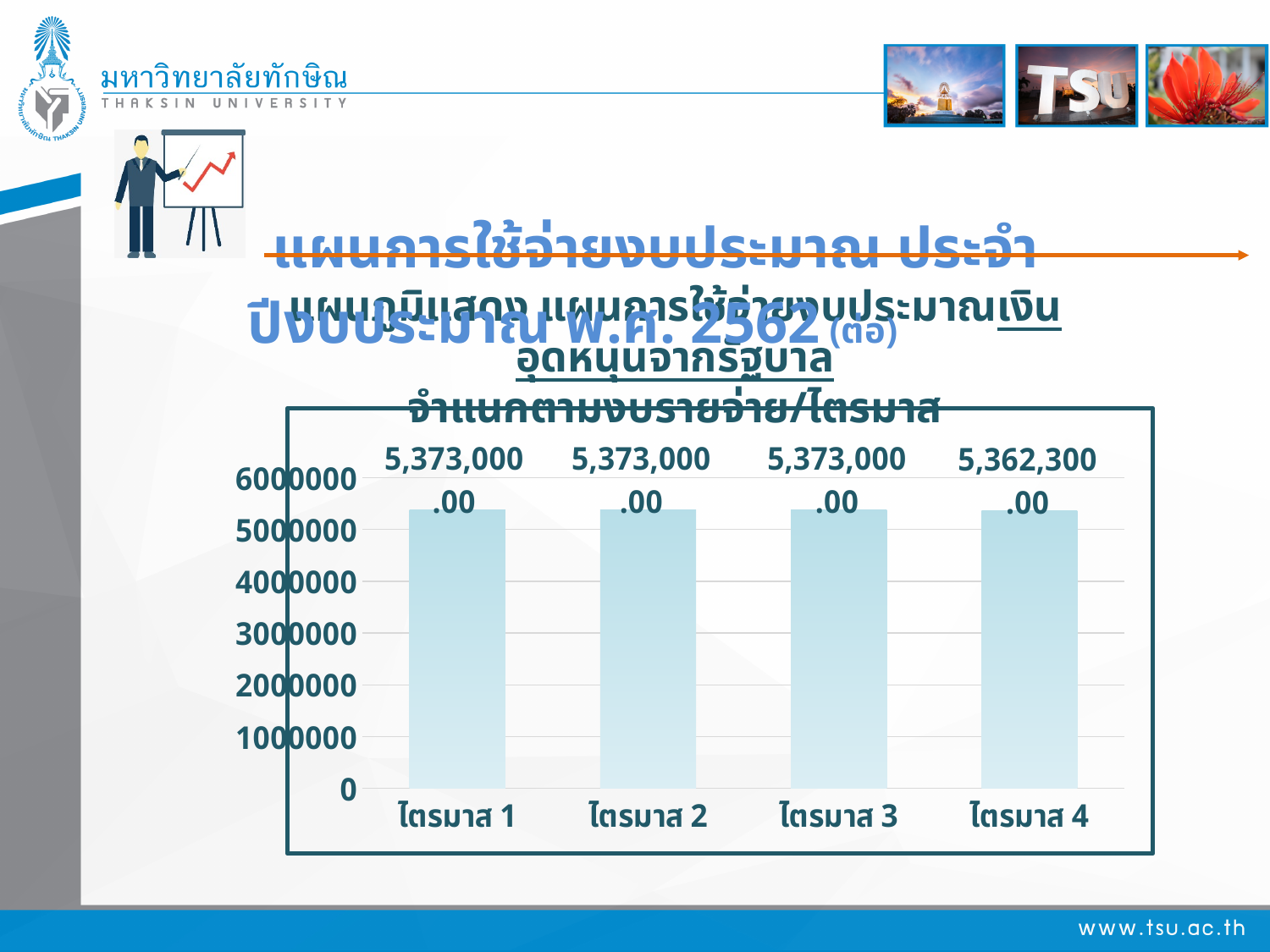
Is the value for ไตรมาส 2 greater or less than 5000000? greater What is the highest tick value shown on the vertical axis? 6000000 Do the values for ไตรมาส 1, 2 and 3 differ from each other? No, they are all 5,373,000.00 What is the value for ไตรมาส 1? 5,373,000.00 How many quarters (categories) are shown on the chart? 4 What kind of chart is shown on the slide? bar chart What is the value for ไตรมาส 2? 5,373,000.00 Which quarter has the lowest value? ไตรมาส 4 Which is larger, the value for ไตรมาส 3 or ไตรมาส 4? ไตรมาส 3 Is the value for ไตรมาส 4 greater or less than 6000000? less What is the difference between the values for ไตรมาส 1 and ไตรมาส 4? 10,700.00 What is the value for ไตรมาส 4? 5,362,300.00